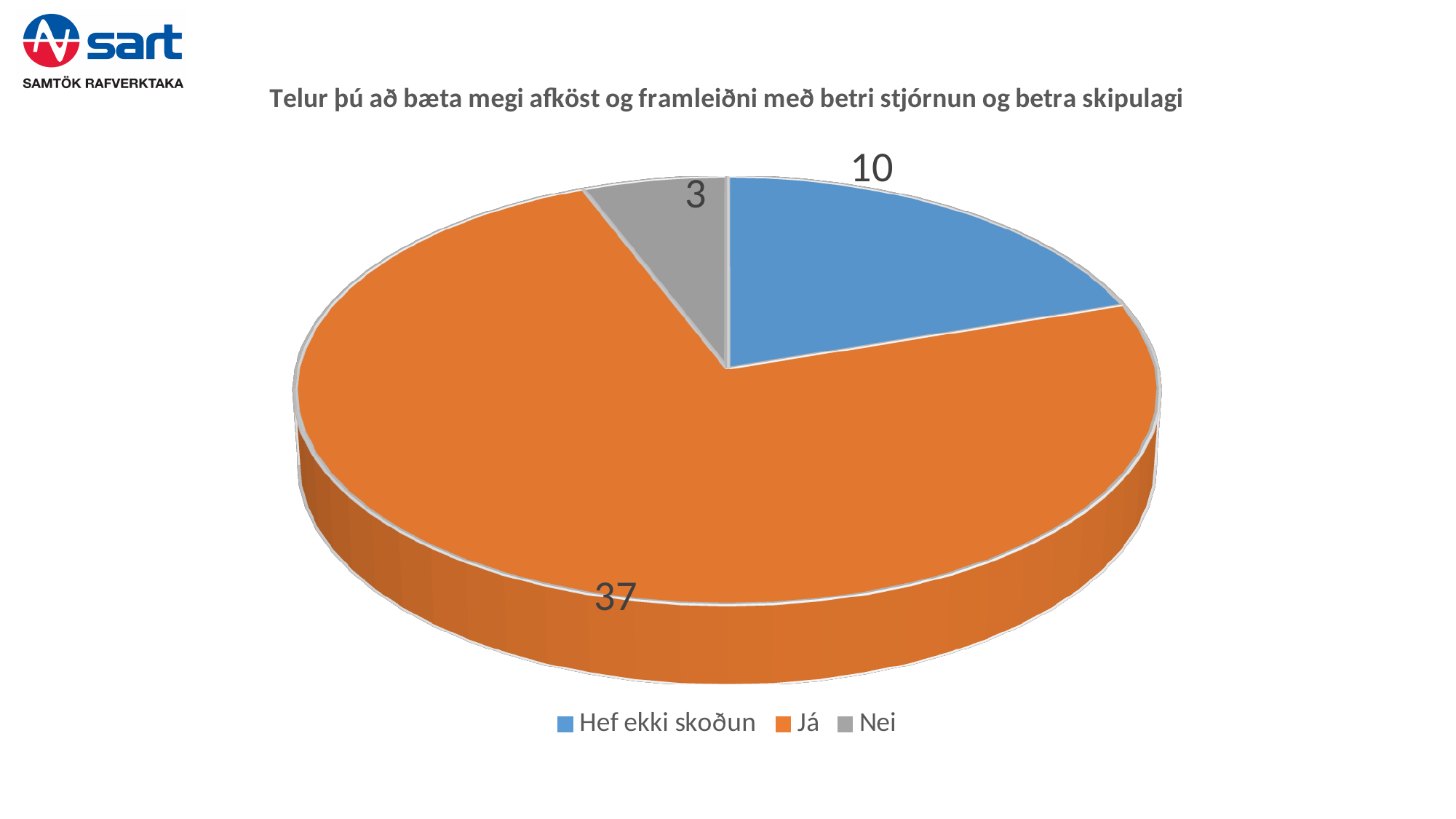
What share of the pie does Já represent? 74% Which is larger, the value for Hef ekki skoðun or the value for Nei? Hef ekki skoðun What is the value for Nei? 3 What is the value for Hef ekki skoðun? 10 What is the total of all slices in the pie chart? 50 Which category has the smallest slice? Nei What is the difference between the values for Já and Hef ekki skoðun? 27 Which category has the largest slice? Já What kind of chart is shown on the slide? Pie chart How many categories does the pie chart have? 3 What colour is the Já slice? Orange What is the value for Já? 37